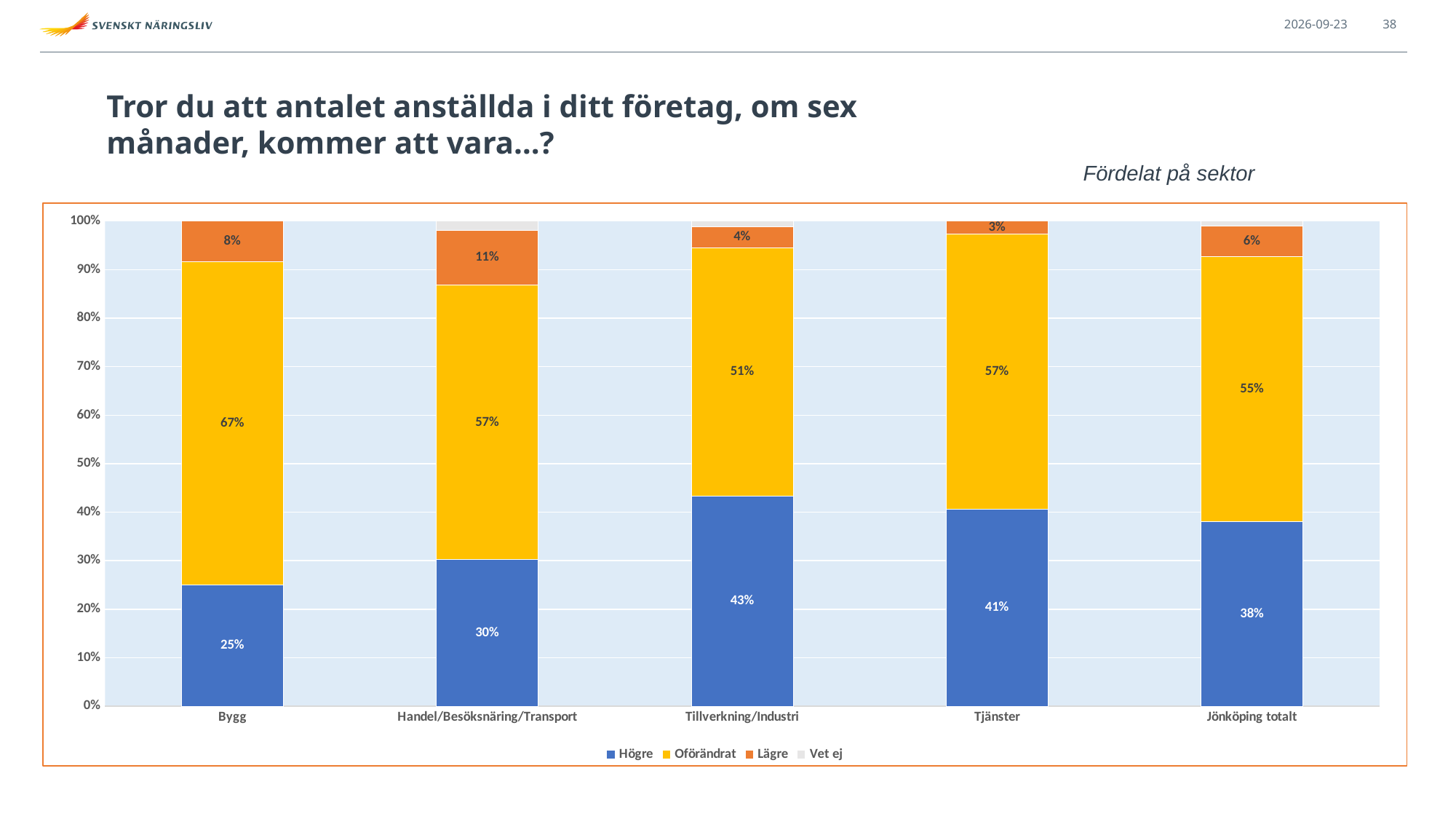
What kind of chart is shown on the slide? Stacked bar chart Which sector has the highest Högre share? Tillverkning/Industri Which colour represents the Oförändrat series in the legend? Yellow What is the Lägre value for Handel/Besöksnäring/Transport? 11% What is the difference in percentage points between the Oförändrat values for Bygg and Handel/Besöksnäring/Transport? 10 percentage points How many sectors (categories) are shown on the x axis? 5 What is the Högre value for Jönköping totalt? 38% Which is larger: the Högre value for Tjänster or the Högre value for Handel/Besöksnäring/Transport? Tjänster What percentage of respondents in Bygg answered Högre? 25% How many series does the legend list? 4 Which sector has the lowest Lägre share? Tjänster What is the Oförändrat value for Tillverkning/Industri? 51%